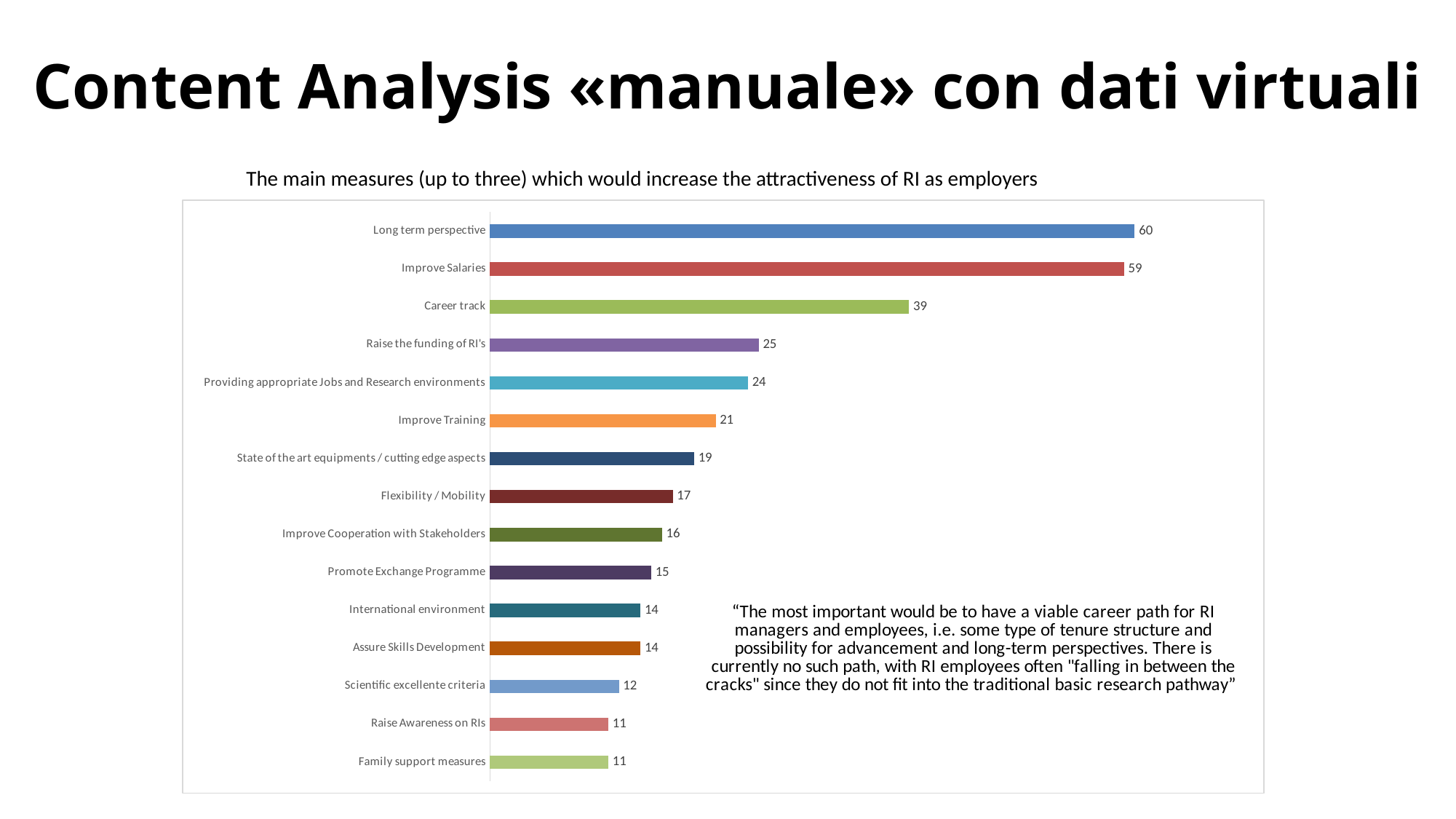
What is the value for Career track? 39 What is the title of the chart? The main measures (up to three) which would increase the attractiveness of RI as employers What is the value for Improve Training? 21 What is the value for Scientific excellente criteria? 12 Which is larger, Improve Salaries or Career track? Improve Salaries Which category has the highest value? Long term perspective Which is larger, Flexibility / Mobility or Improve Cooperation with Stakeholders? Flexibility / Mobility What is the difference between Long term perspective and Improve Salaries? 1 What kind of chart is shown on the slide? Bar chart What is the value for Long term perspective? 60 How many categories are shown in the chart? 15 What is the difference between Career track and Raise the funding of RI's? 14